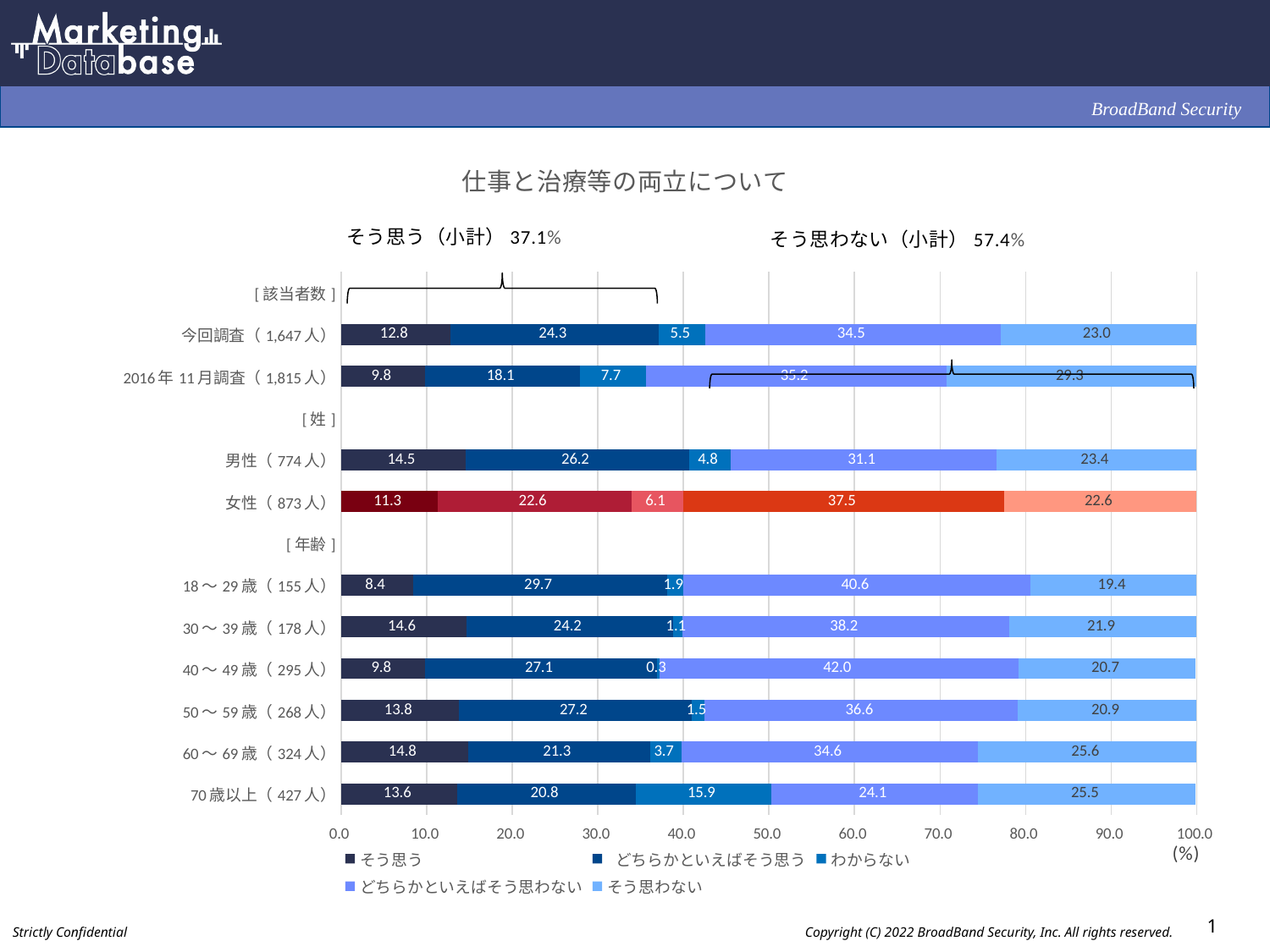
What is the value of どちらかといえばそう思わない for 40～49歳 (295人)? 42.0 What is the value of そう思う for 今回調査 (1,647人)? 12.8 How many categories (bars) are plotted in the chart? 10 Which is larger, the どちらかといえばそう思う value for 男性 (774人) or for 女性 (873人)? 男性 (774人) What is the value of わからない for 70歳以上 (427人)? 15.9 What type of chart is shown on the slide? Stacked bar chart Which category has the lowest value for そう思う? 18～29歳 (155人) What is the difference between the そう思わない values for 2016年11月調査 (1,815人) and 今回調査 (1,647人)? 6.3 What is the そう思う (小計) percentage shown above the chart? 37.1% What is the title of the chart? 仕事と治療等の両立について How many series does the legend list? 5 Which category has the highest value for わからない? 70歳以上 (427人)